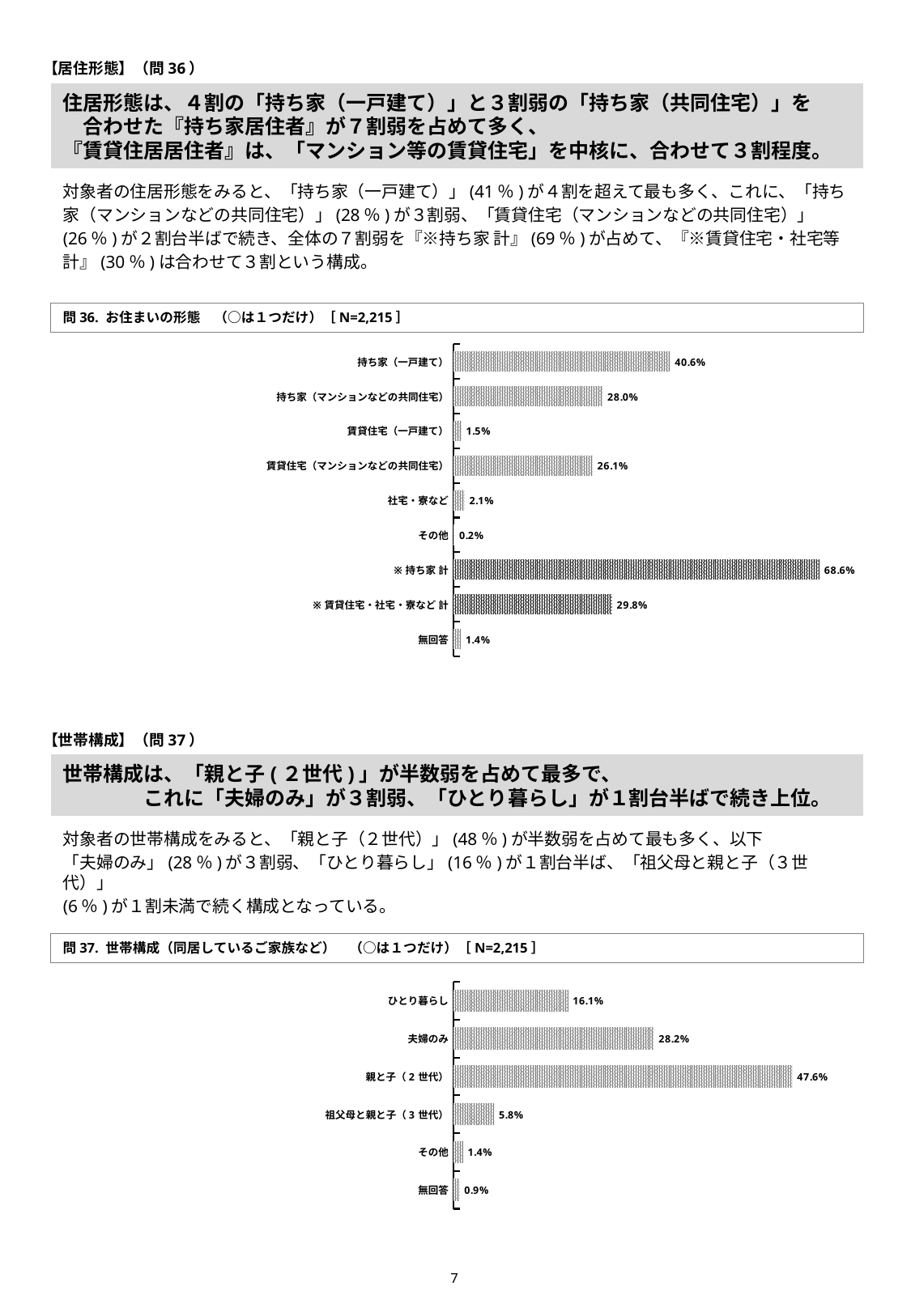
In the 問37 世帯構成 chart, what is the value for 親と子（2世代）? 47.6% How many categories are shown in the 問36 お住まいの形態 chart? 9 In the 問36 お住まいの形態 chart, what is the value for 持ち家（一戸建て）? 40.6% How many categories are shown in the 問37 世帯構成 chart? 6 In the 問36 お住まいの形態 chart, what is the difference between ※持ち家 計 and ※賃貸住宅・社宅・寮など 計? 38.8% In the 問37 世帯構成 chart, what is the value for 祖父母と親と子（3世代）? 5.8% In the 問36 お住まいの形態 chart, what is the value for 賃貸住宅（マンションなどの共同住宅）? 26.1% In the 問36 お住まいの形態 chart, which is larger: 持ち家（マンションなどの共同住宅） or 賃貸住宅（マンションなどの共同住宅）? 持ち家（マンションなどの共同住宅） In the 問37 世帯構成 chart, what is the difference between 夫婦のみ and ひとり暮らし? 12.1% In the 問36 お住まいの形態 chart, which category has the lowest value? その他 In the 問37 世帯構成 chart, which category has the highest value? 親と子（2世代） What kind of chart is the 問36 お住まいの形態 chart? Bar chart